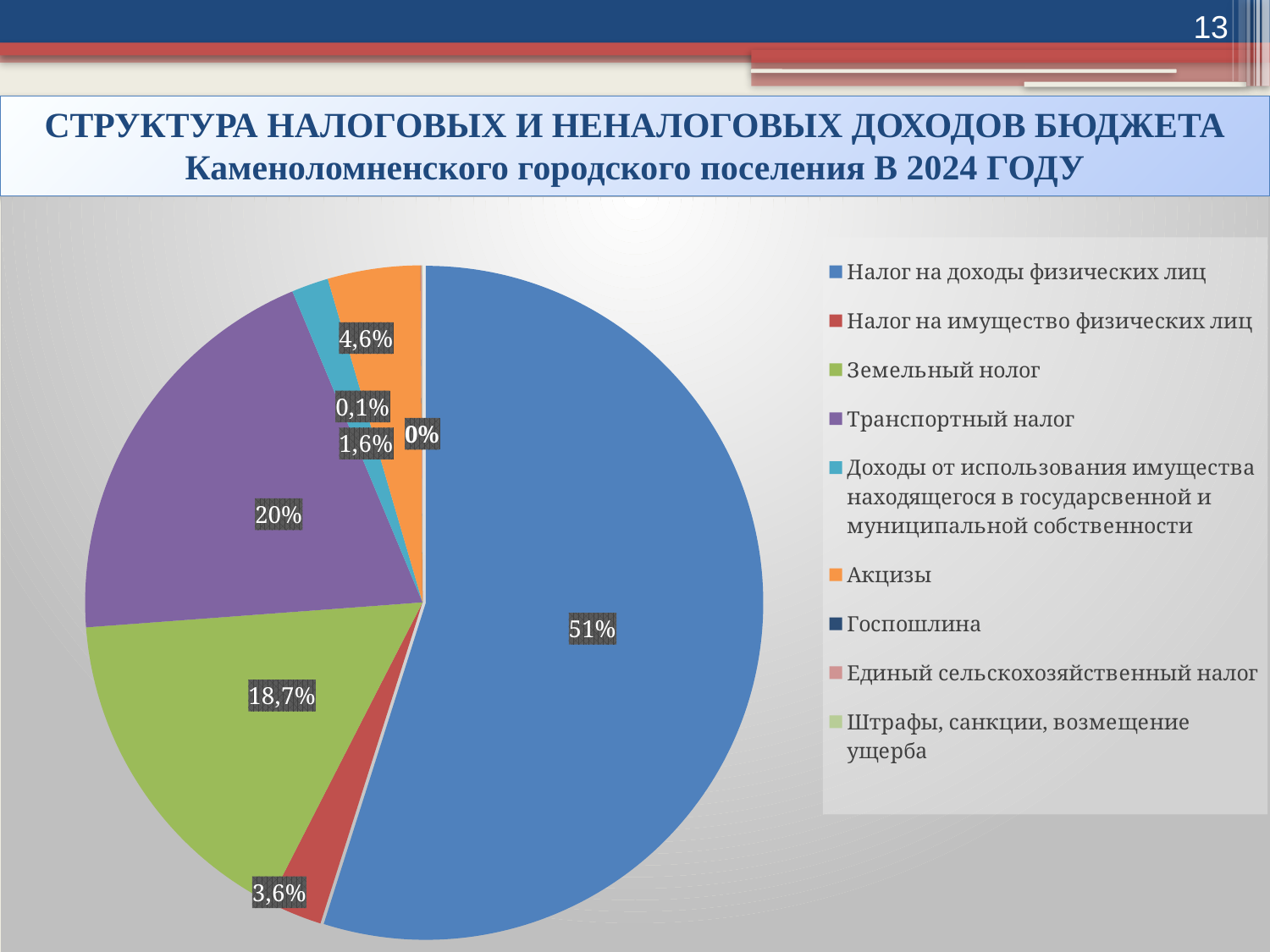
What share of the pie is labelled for Акцизы? 4,6% How many entries does the legend list? 9 Which year does the slide title say the budget revenue structure refers to? 2024 Which is larger, the slice for Транспортный налог or the slice for Земельный нолог? Транспортный налог What share of the pie is labelled for Земельный нолог? 18,7% Which category has the largest slice of the pie? Налог на доходы физических лиц What share of the pie is labelled for Налог на имущество физических лиц? 3,6% By how many percentage points does the Транспортный налог slice exceed the Земельный нолог slice? 1,3 What share of the pie is labelled for Транспортный налог? 20% What share of the pie is labelled for Налог на доходы физических лиц? 51% What kind of chart is shown on the slide? pie chart What share of the pie is labelled for Доходы от использования имущества находящегося в государсвенной и муниципальной собственности? 1,6%